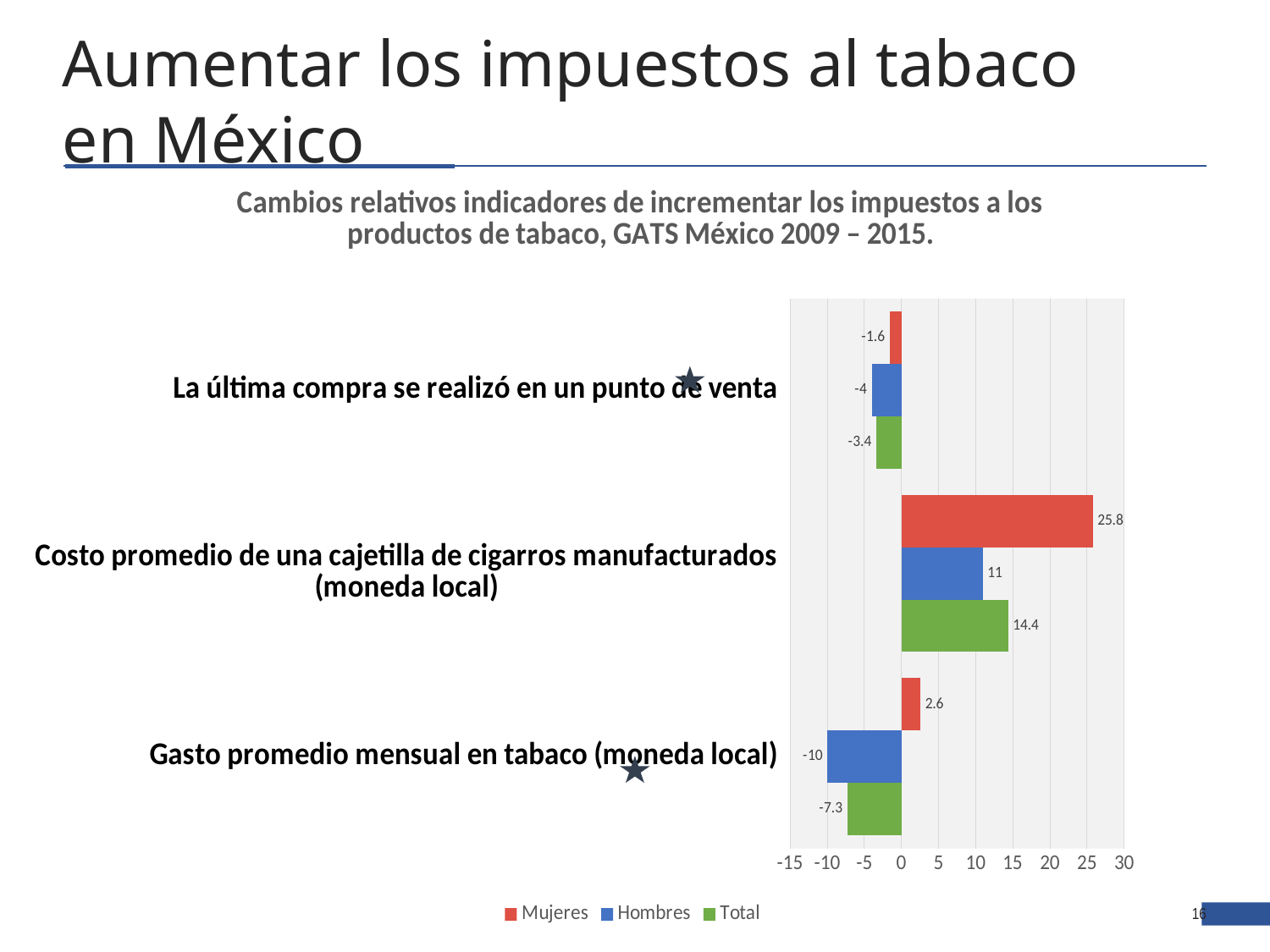
Which series has the highest value in the category 'Costo promedio de una cajetilla de cigarros manufacturados (moneda local)'? Mujeres What is the value for Hombres in the category 'Gasto promedio mensual en tabaco (moneda local)'? -10 What is the difference between the Mujeres and Hombres values for 'Costo promedio de una cajetilla de cigarros manufacturados (moneda local)'? 14.8 What colour represents the Total series in the chart? Green How many categories are shown on the chart? 3 What is the Total value for 'La última compra se realizó en un punto de venta'? -3.4 How many series does the legend list? 3 What is the value for Mujeres in the category 'Costo promedio de una cajetilla de cigarros manufacturados (moneda local)'? 25.8 Which series has the lowest value in the category 'Gasto promedio mensual en tabaco (moneda local)'? Hombres What type of chart is shown on the slide? Bar chart Which is larger: the Total value for 'Costo promedio de una cajetilla de cigarros manufacturados (moneda local)' or the Total value for 'Gasto promedio mensual en tabaco (moneda local)'? Costo promedio de una cajetilla de cigarros manufacturados (moneda local) What is the value for Hombres in the category 'Costo promedio de una cajetilla de cigarros manufacturados (moneda local)'? 11